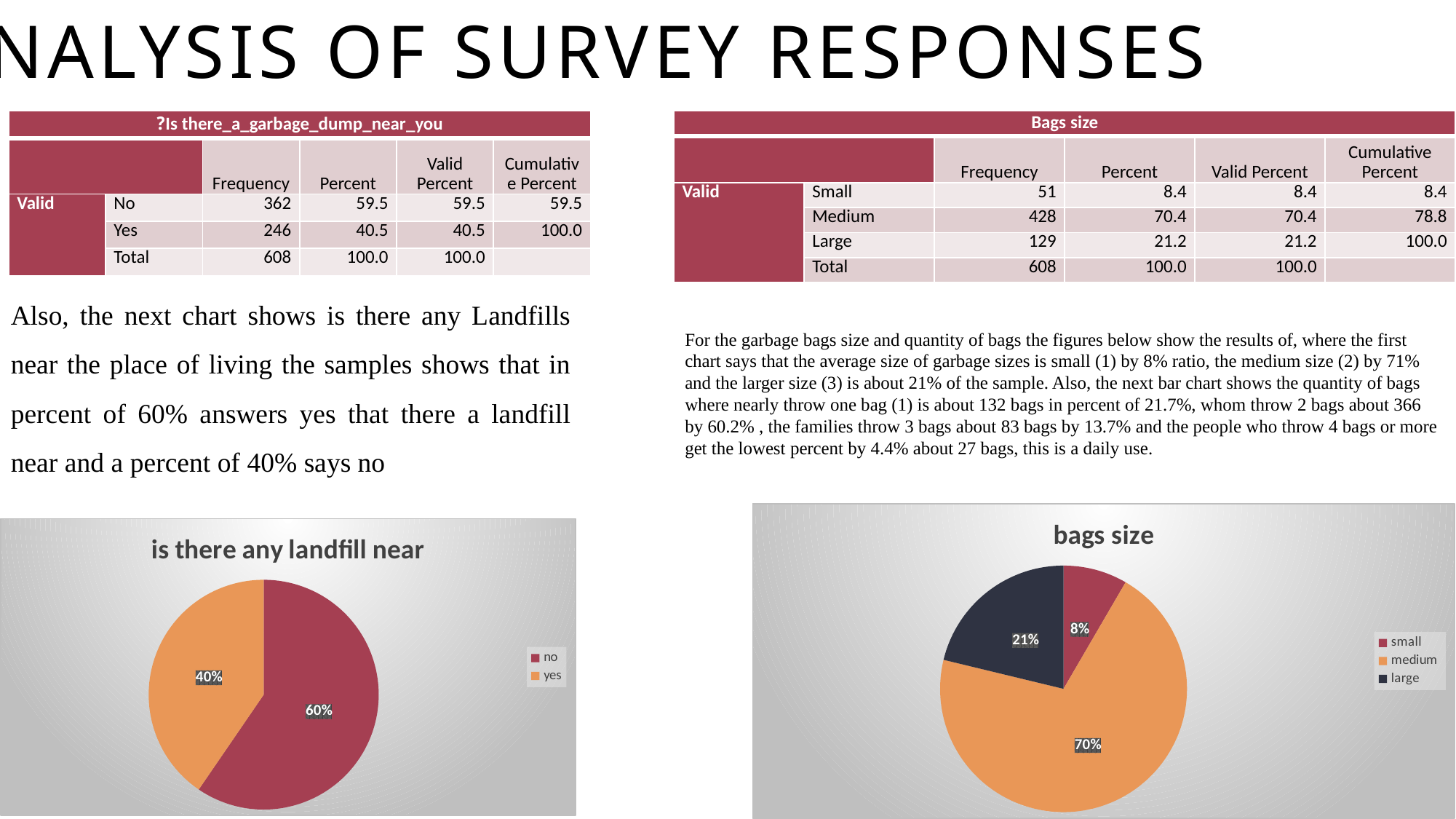
In the 'bags size' chart, what share of the pie is labelled 'small'? 8% What kind of chart is the 'is there any landfill near' chart? pie chart In the 'is there any landfill near' chart, what share of the pie is labelled 'no'? 60% In the 'is there any landfill near' chart, what share of the pie is labelled 'yes'? 40% In the 'bags size' chart, which category has the largest slice? medium How many entries does the legend of the 'is there any landfill near' chart list? 2 In the 'is there any landfill near' chart, what is the difference between the 'no' and 'yes' shares? 20% In the 'is there any landfill near' chart, which slice is larger, 'no' or 'yes'? no In the 'bags size' chart, which category has the smallest slice? small How many slices does the 'bags size' pie chart have? 3